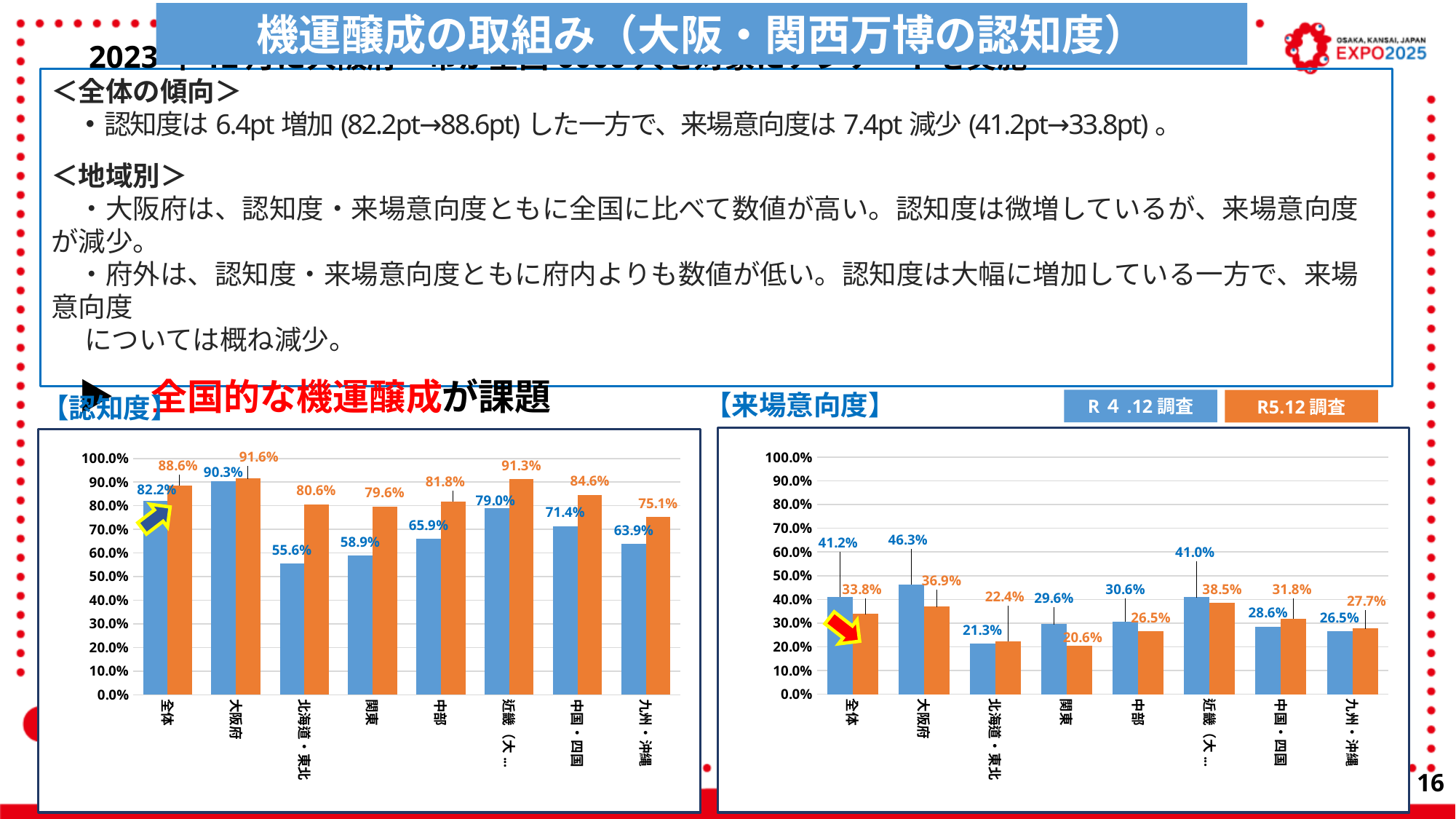
In the 【来場意向度】 chart, what is the difference between the R４.12調査 and R5.12調査 values for 全体? 7.4% In the 【認知度】 chart, what is the R5.12調査 value for 九州・沖縄? 75.1% In the 【認知度】 chart, what is the R5.12調査 value for 北海道・東北? 80.6% In the 【認知度】 chart, what is the R４.12調査 value for 大阪府? 90.3% In the 【認知度】 chart, what is the difference between the R5.12調査 and R４.12調査 values for 関東? 20.7% What type of chart is the 【来場意向度】 chart? Bar chart In the 【来場意向度】 chart, which is larger for 中国・四国: the R４.12調査 value or the R5.12調査 value? R5.12調査 How many series does the legend list for the charts? 2 How many categories are shown on the x axis of the 【認知度】 chart? 8 In the 【認知度】 chart, which category has the lowest R４.12調査 value? 北海道・東北 In the 【来場意向度】 chart, which category has the highest R４.12調査 value? 大阪府 In the 【来場意向度】 chart, what is the R5.12調査 value for 関東? 20.6%